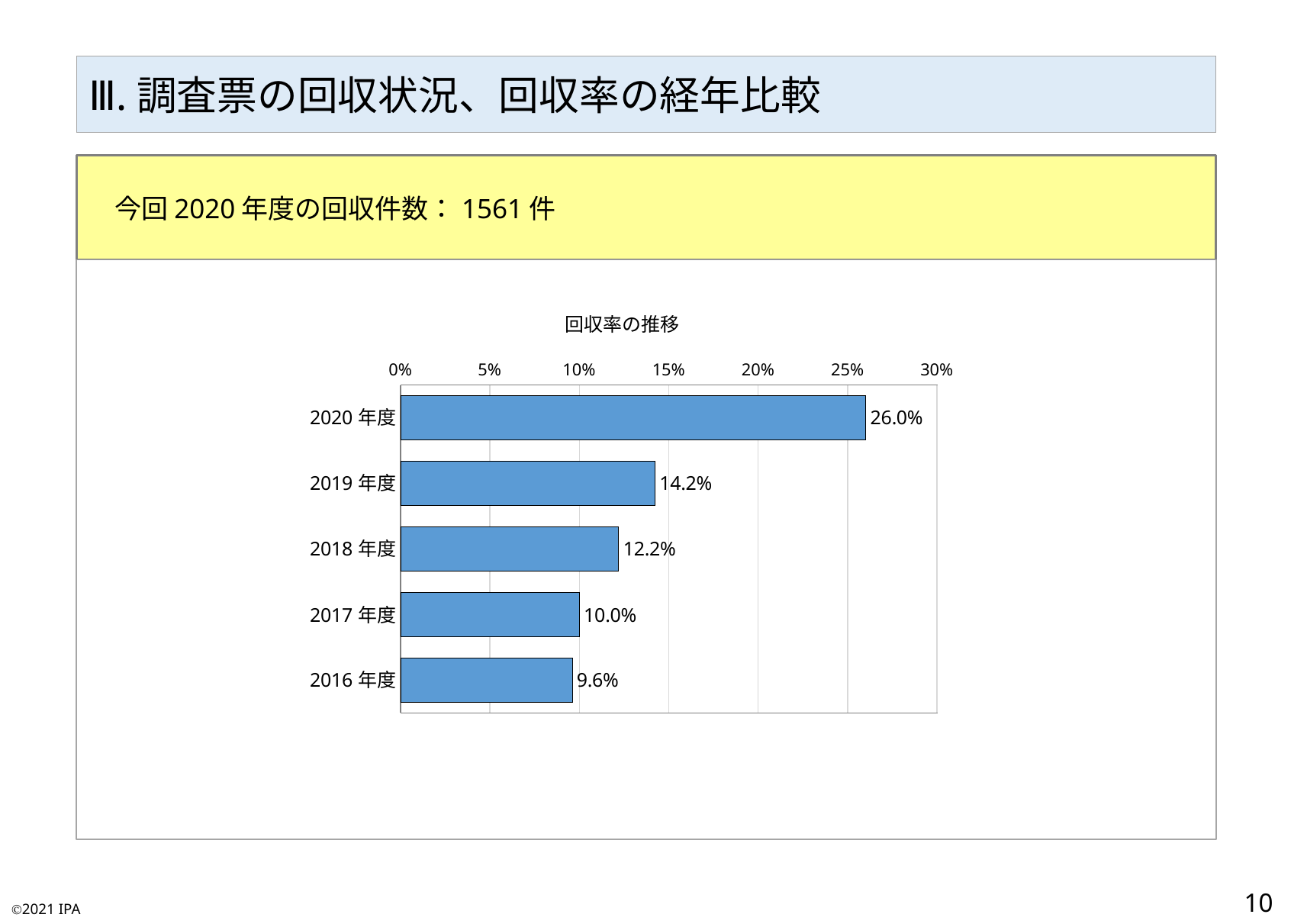
What is the title of the chart? 回収率の推移 What is the difference between the response rates for 2020 年度 and 2019 年度? 11.8% What is the response rate for 2016 年度? 9.6% What kind of chart is shown on the slide? bar chart Which has a higher response rate, 2019 年度 or 2018 年度? 2019 年度 What is the response rate for 2020 年度? 26.0% What is the difference between the response rates for 2018 年度 and 2017 年度? 2.2% Is the value for 2019 年度 greater or less than 15%? less What is the response rate for 2017 年度? 10.0% Which fiscal year has the highest response rate? 2020 年度 Which fiscal year has the lowest response rate? 2016 年度 How many fiscal years are shown in the chart? 5